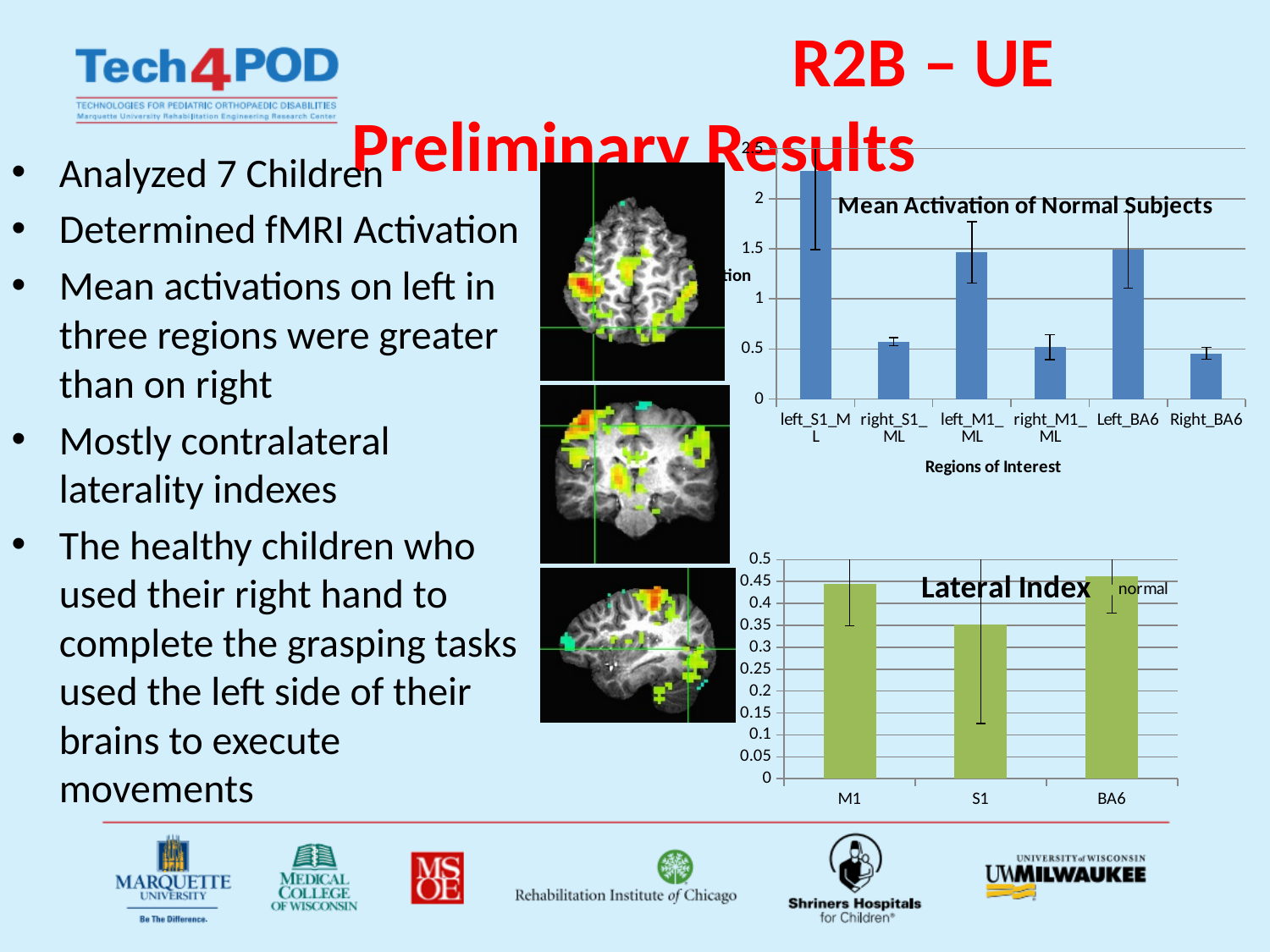
What kind of chart is the Lateral Index chart? bar chart In the Mean Activation of Normal Subjects chart, is the value for left_M1_ML greater or less than 1? greater In the Mean Activation of Normal Subjects chart, is the value for left_S1_ML greater or less than 2? greater In the Mean Activation of Normal Subjects chart, is the value for Right_BA6 greater or less than 1? less In the Lateral Index chart, which region has the lowest lateral index? S1 What is the x-axis title of the Mean Activation of Normal Subjects chart? Regions of Interest In the Mean Activation of Normal Subjects chart, which is larger, left_S1_ML or right_S1_ML? left_S1_ML In the Mean Activation of Normal Subjects chart, which is larger, Left_BA6 or Right_BA6? Left_BA6 How many regions of interest are shown in the Mean Activation of Normal Subjects chart? 6 In the Mean Activation of Normal Subjects chart, which region of interest has the highest mean activation? left_S1_ML